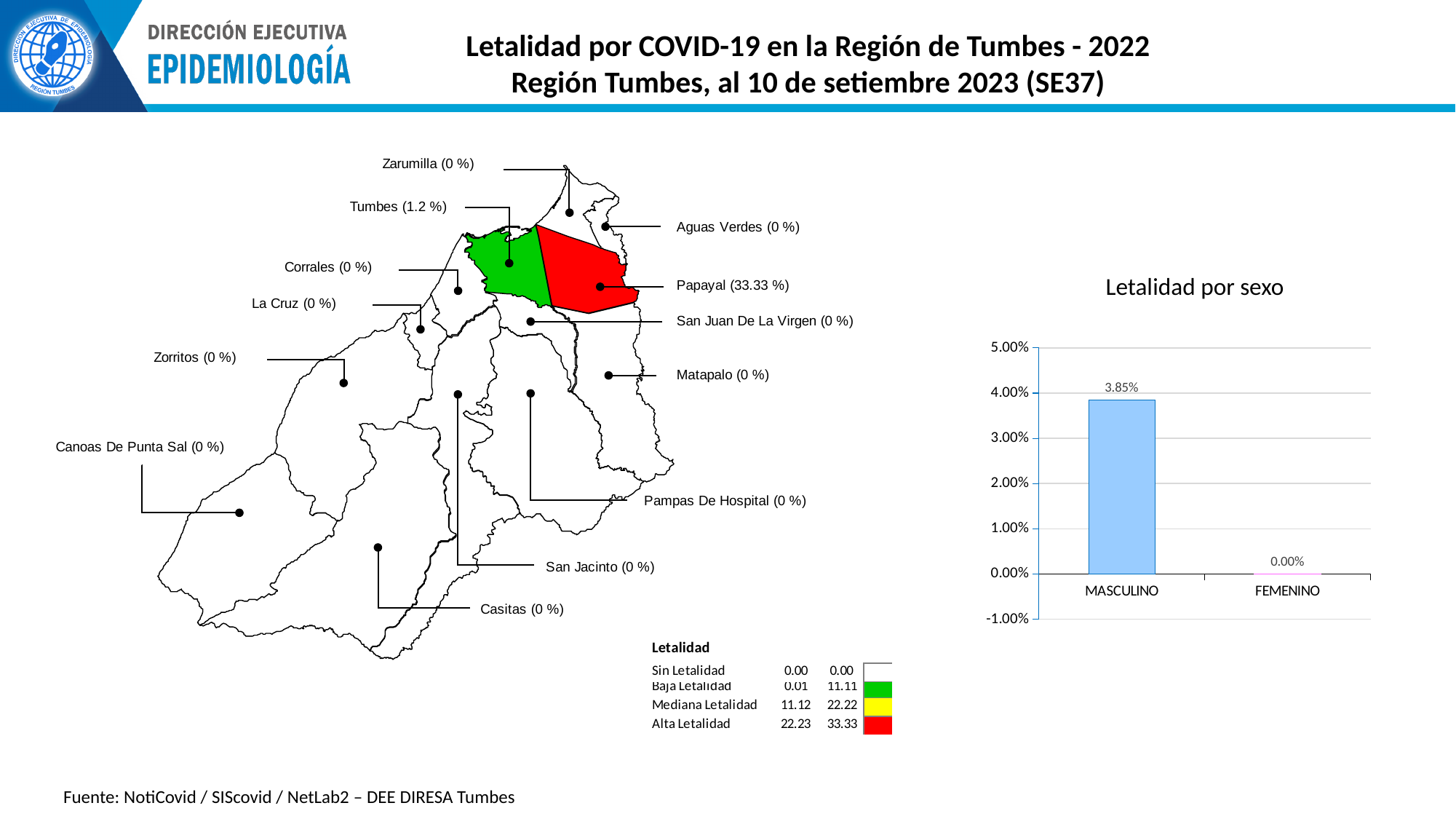
On the map, which district has the highest lethality value? Papayal In the 'Letalidad por sexo' chart, what is the value for FEMENINO? 0.00% In the 'Letalidad por sexo' chart, what is the value for MASCULINO? 3.85% In the 'Letalidad por sexo' chart, what is the difference between the MASCULINO and FEMENINO values? 3.85% In the 'Letalidad por sexo' chart, which category has the highest value? MASCULINO On the map, what is the lethality value shown for Papayal? 33.33 % In the 'Letalidad por sexo' chart, is the value for MASCULINO greater or less than 3.00%? greater In the 'Letalidad por sexo' chart, what is the highest value shown on the y axis? 5.00% In the 'Letalidad por sexo' chart, how many categories are shown on the x axis? 2 What kind of chart is 'Letalidad por sexo'? bar chart On the map, what is the lethality value shown for Tumbes? 1.2 % In the 'Letalidad por sexo' chart, which category has the lowest value? FEMENINO